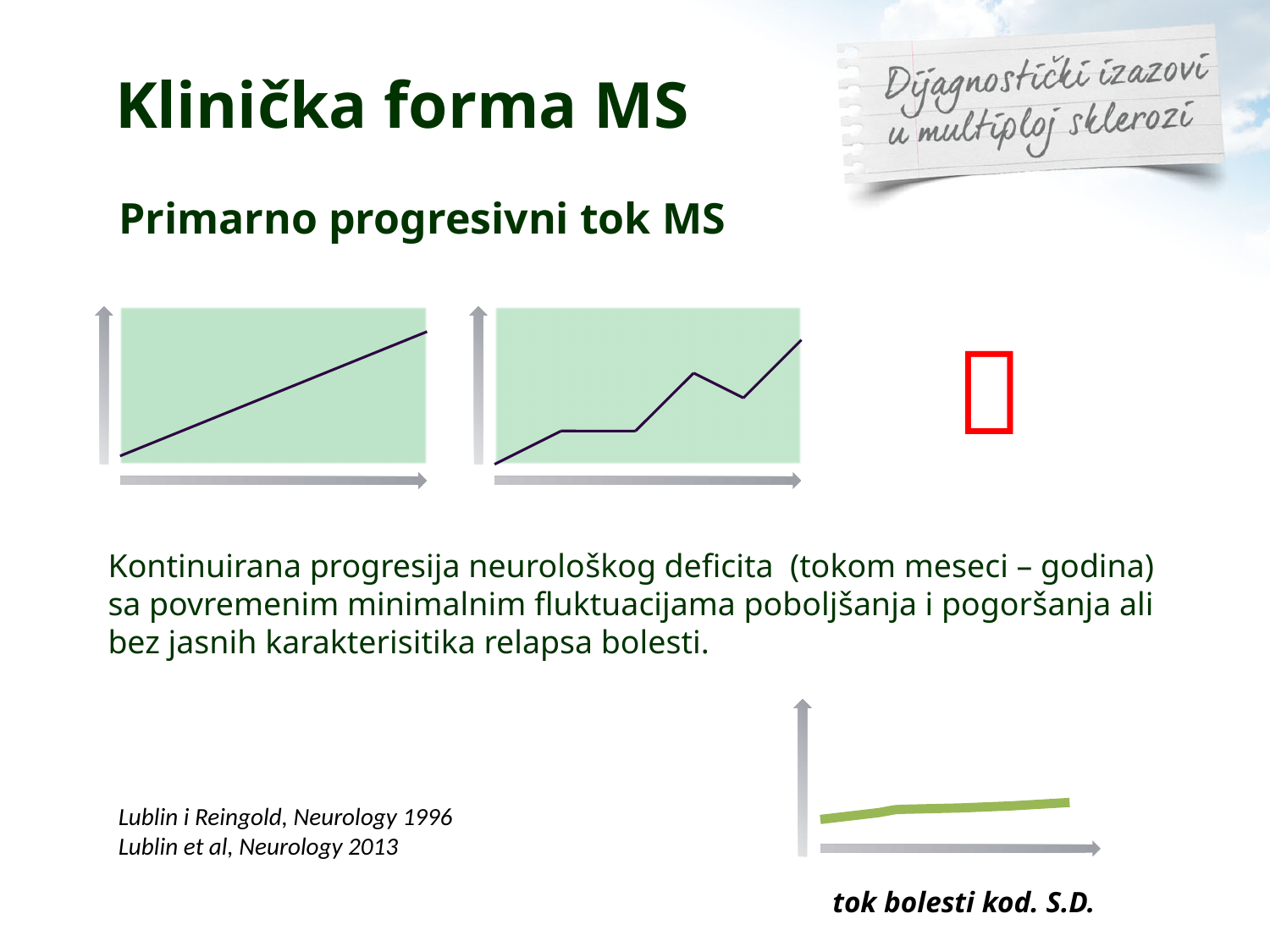
In the left chart under "Primarno progresivni tok MS", does the line rise or fall along the x axis? rise What is the caption written below the bottom-right chart? tok bolesti kod. S.D. What kind of chart is the middle chart under the heading "Primarno progresivni tok MS"? line chart How many line charts are shown on the slide? 3 What kind of chart is the left chart under the heading "Primarno progresivni tok MS"? line chart In the middle chart under "Primarno progresivni tok MS", does the line overall rise or fall from left to right? rise In the bottom-right chart labelled "tok bolesti kod. S.D.", does the line rise or fall along the x axis? rise What kind of chart is the chart at the bottom right labelled "tok bolesti kod. S.D."? line chart